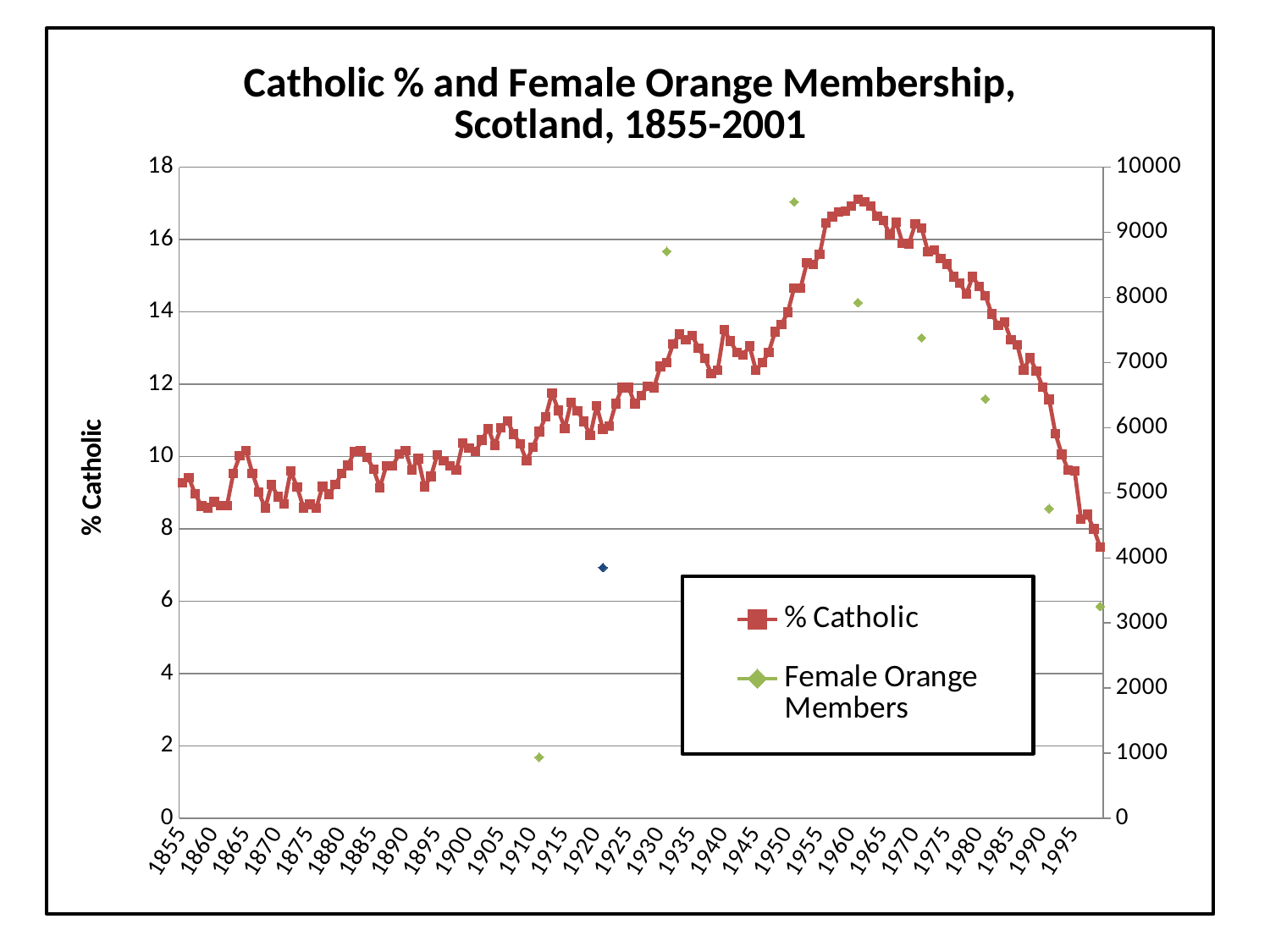
Does the % Catholic series rise or fall between 1965 and 2000? fall What is the title of the chart? Catholic % and Female Orange Membership, Scotland, 1855-2001 Which series is plotted with green diamond markers? Female Orange Members Which is larger, the % Catholic value in 1960 or in 1900? 1960 Which is larger, the Female Orange Members value around 1952 or around 1992? around 1952 Is the peak % Catholic value, reached in the early 1960s, greater or less than 16? greater How many series does the legend list? 2 Is the Female Orange Members value plotted around 1912 greater or less than 1000? less Is the % Catholic value in 1855 greater or less than 10? less What kind of chart is shown on the slide? line chart